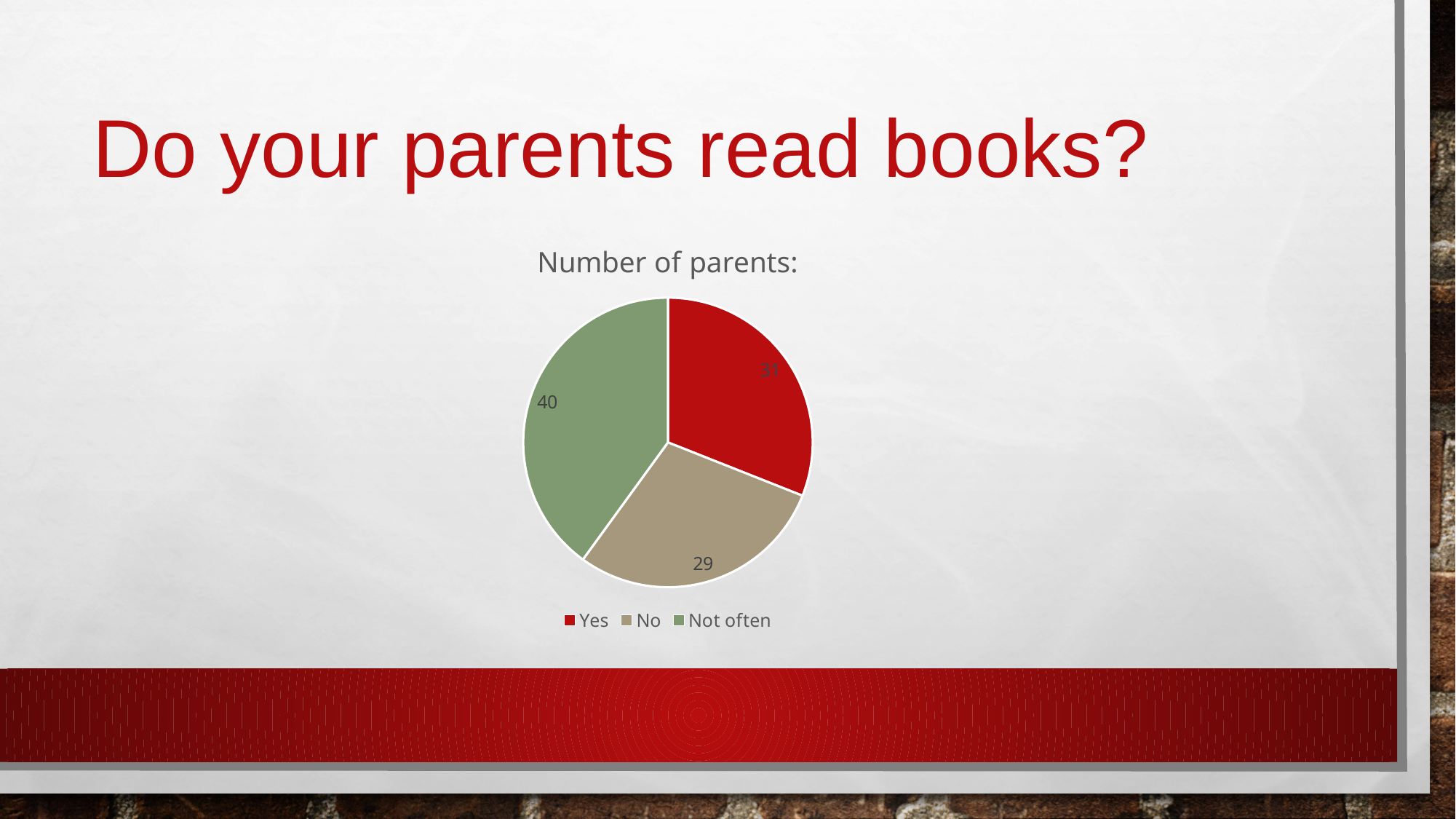
What is the value for Yes in the pie chart? 31 Which category has the largest slice in the pie chart? Not often What is the difference between the values for Yes and No? 2 What share of the pie does the Not often slice represent? 40% Which is larger, the value for Not often or the value for Yes? Not often What is the difference between the values for Not often and No? 11 What is the value for Not often in the pie chart? 40 Which category has the smallest slice in the pie chart? No What is the value for No in the pie chart? 29 What is the title of the chart? Number of parents: How many categories does the pie chart show? 3 What kind of chart is shown on the slide? Pie chart